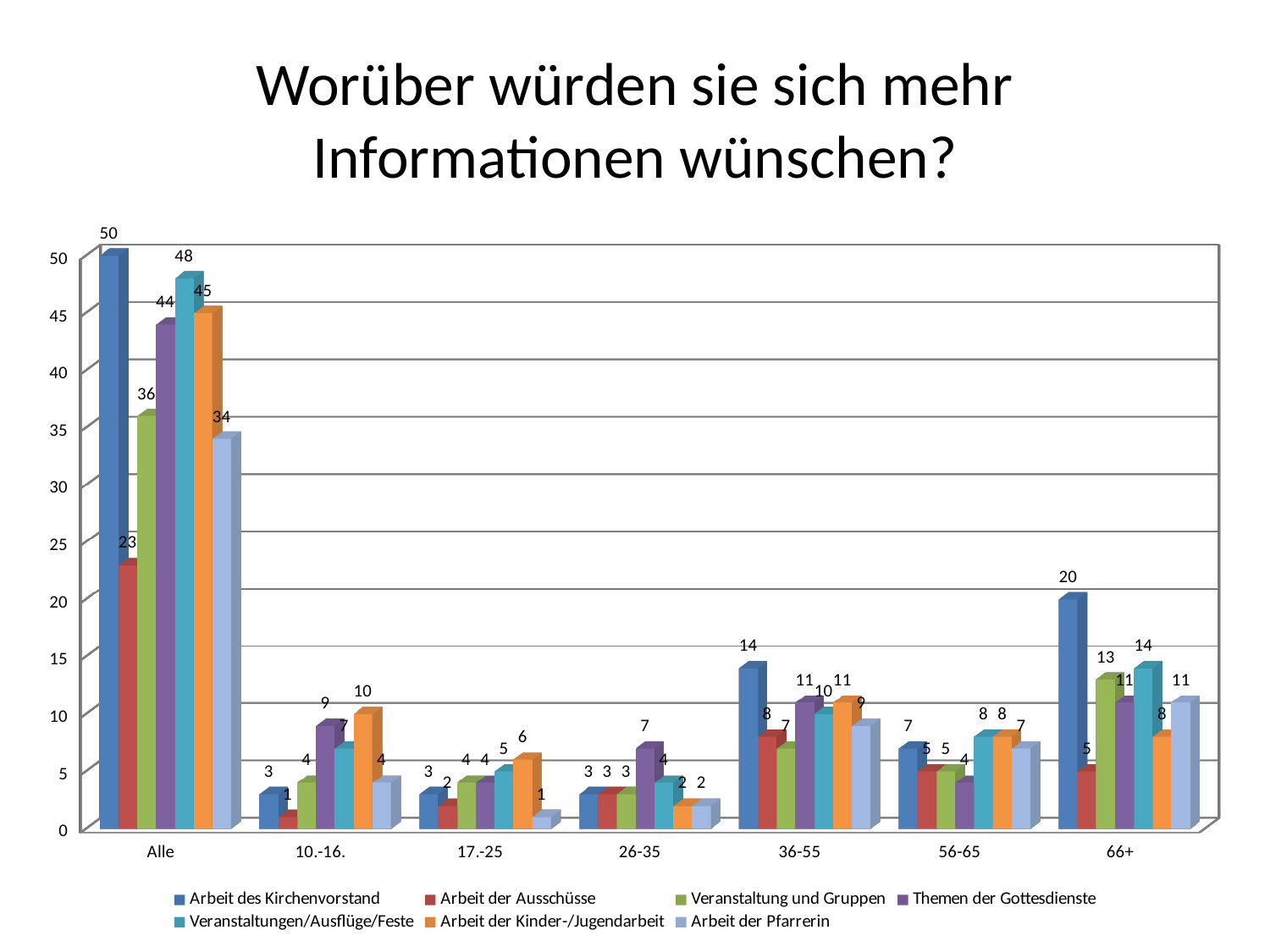
What is the value for Veranstaltung und Gruppen in the 66+ category? 13 What is the difference between Arbeit des Kirchenvorstand and Arbeit der Ausschüsse in the Alle category? 27 How many series does the legend list? 7 In the 36-55 category, which is larger: Arbeit des Kirchenvorstand or Arbeit der Ausschüsse? Arbeit des Kirchenvorstand What is the value for Arbeit des Kirchenvorstand in the Alle category? 50 What is the value for Arbeit der Kinder-/Jugendarbeit in the 10.-16. category? 10 Which series has the lowest value in the 17.-25 category? Arbeit der Pfarrerin How many age categories are shown on the x axis? 7 Which series has the highest value in the Alle category? Arbeit des Kirchenvorstand What is the value for Themen der Gottesdienste in the 26-35 category? 7 What kind of chart is shown on the slide? Bar chart What is the title of the chart? Worüber würden sie sich mehr Informationen wünschen?